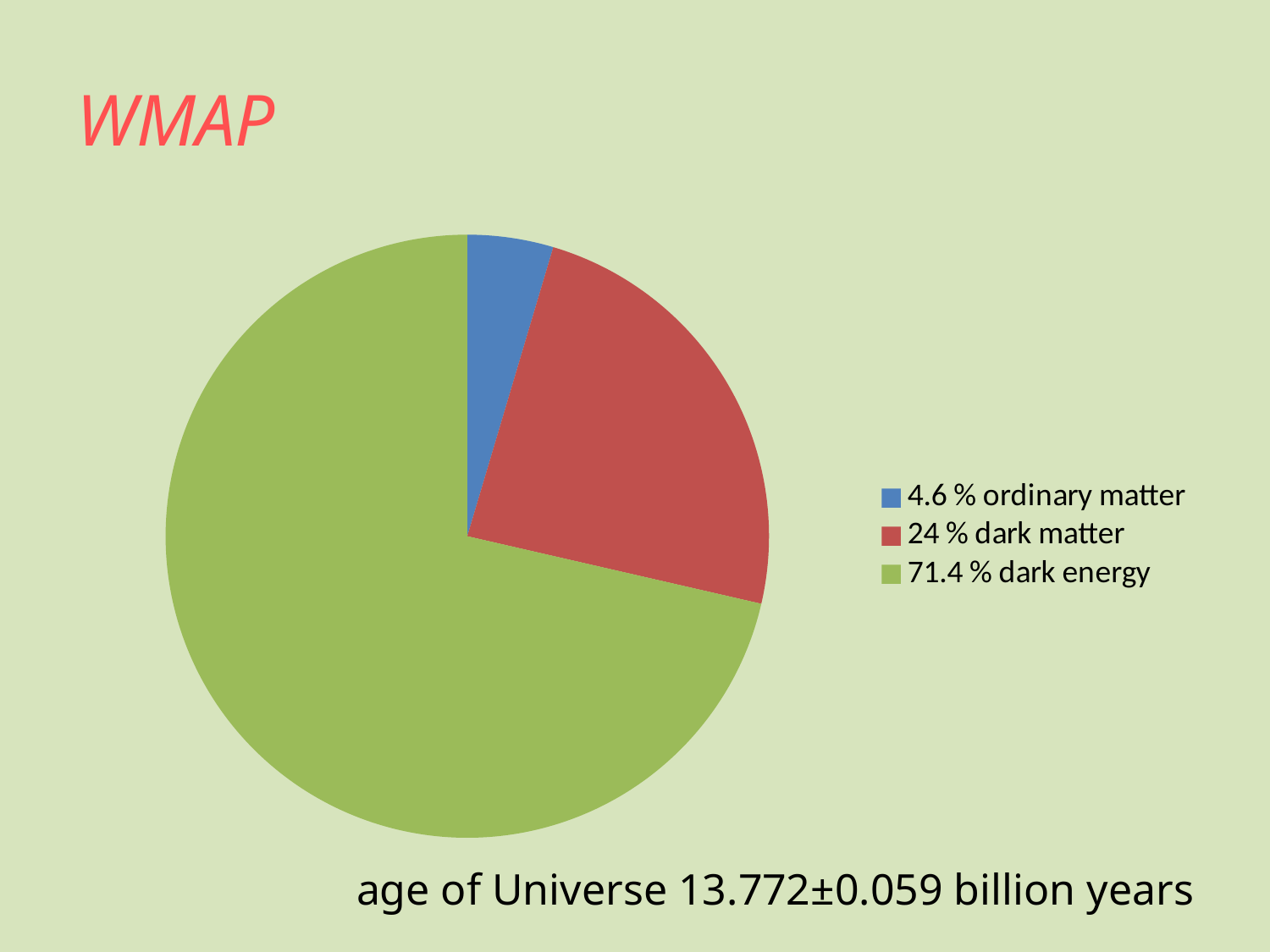
Which component has the smallest slice of the pie? ordinary matter How many slices does the pie chart have? 3 Which component has the largest slice of the pie? dark energy What percentage does the legend give for dark matter? 24 % What is the title shown at the top of the slide? WMAP Which is larger, the dark matter slice or the ordinary matter slice? dark matter What percentage does the legend give for ordinary matter? 4.6 % How many entries does the legend list? 3 What colour is the dark energy slice? green What kind of chart is shown on the slide? pie chart What percentage does the legend give for dark energy? 71.4 % What is the difference in percentage points between dark energy and dark matter? 47.4